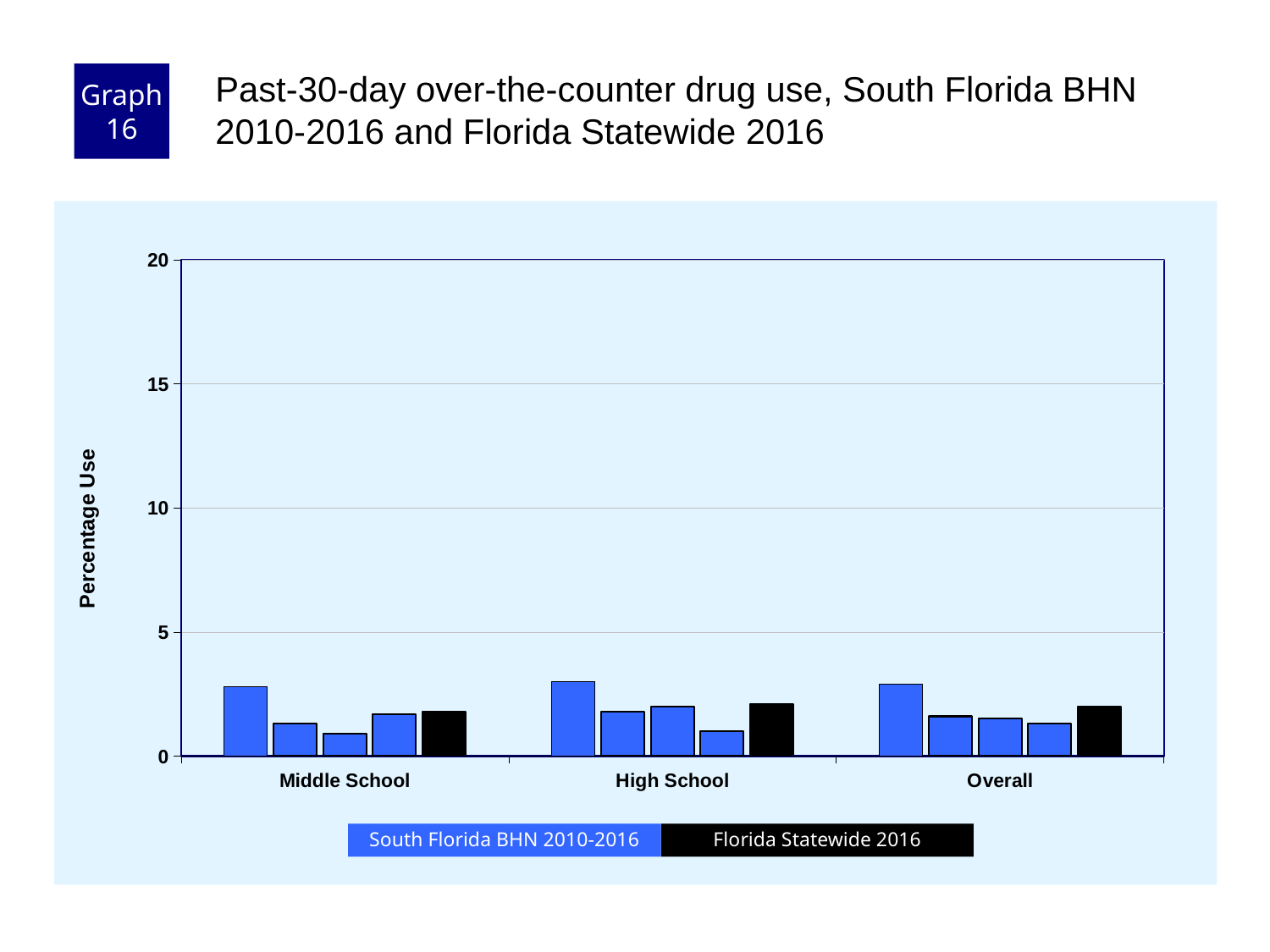
For High School, which is larger: the first (leftmost) South Florida BHN bar or the Florida Statewide 2016 bar? the first South Florida BHN bar How many series does the legend list? 2 Are any of the bars in the chart greater than 10? no What is the highest value shown on the y axis? 20 How many categories are shown on the x axis? 3 Is the Florida Statewide 2016 value for Middle School greater or less than 5? less Is the Florida Statewide 2016 value for High School greater or less than 5? less What is the title of the y axis? Percentage Use For Middle School, which is larger: the first (leftmost) South Florida BHN bar or the Florida Statewide 2016 bar? the first South Florida BHN bar What kind of chart is shown on the slide? bar chart Which colour represents Florida Statewide 2016 in the legend? black